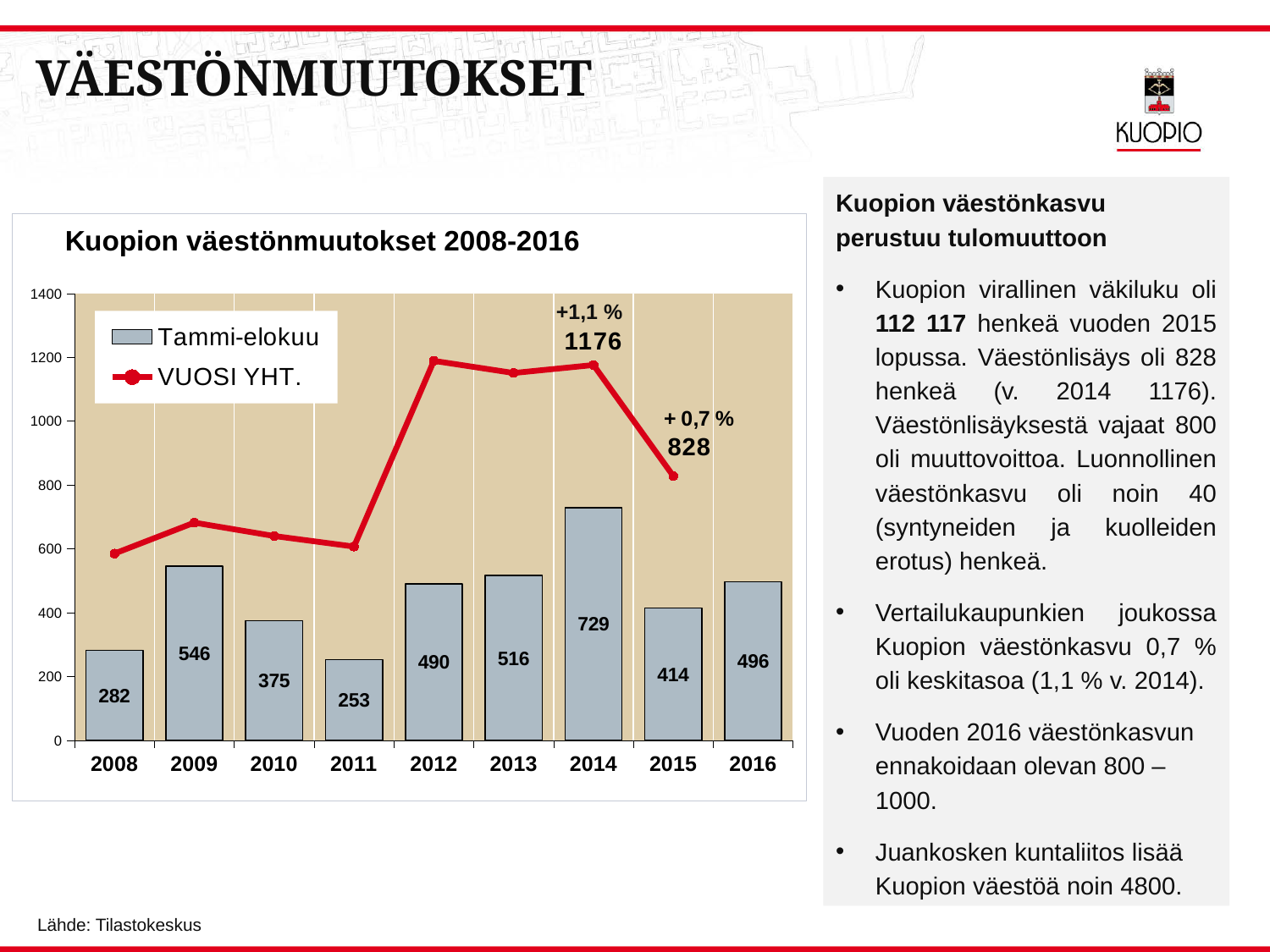
What is the Tammi-elokuu value for 2014? 729 Which is larger, the Tammi-elokuu value for 2009 or for 2016? 2009 Is the VUOSI YHT. value for 2012 greater or less than 1000? greater What is the VUOSI YHT. value for 2015? 828 What is the Tammi-elokuu value for 2011? 253 Which year has the highest Tammi-elokuu bar? 2014 How many years are shown on the x axis? 9 What is the difference between the VUOSI YHT. values for 2014 and 2015? 348 How many series does the legend list? 2 What is the title of the chart? Kuopion väestönmuutokset 2008-2016 What is the difference between the Tammi-elokuu values for 2014 and 2015? 315 Which year has the lowest Tammi-elokuu bar? 2011